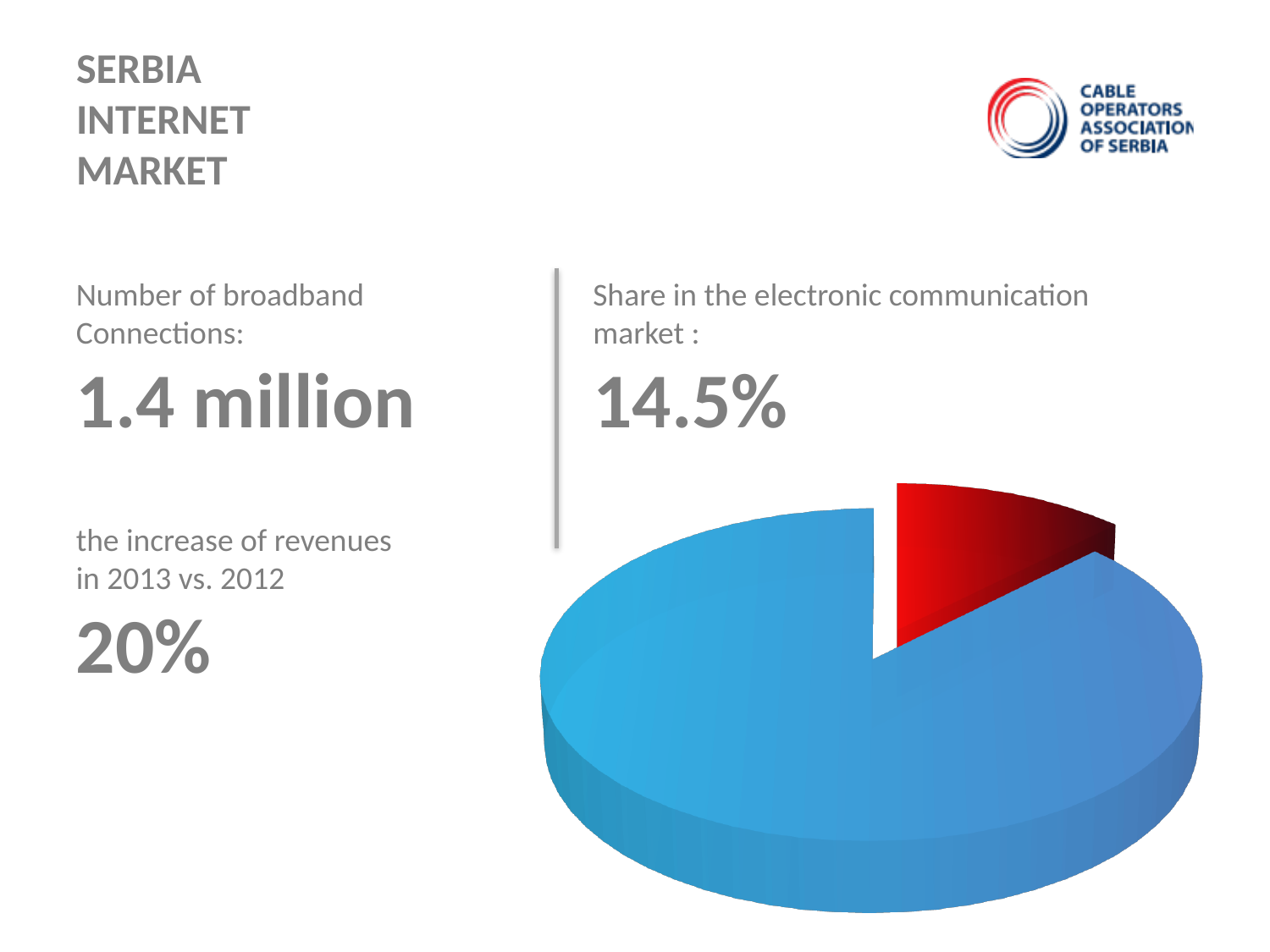
Which slice of the pie chart is the largest? the blue slice Which slice of the pie chart is the smallest? the red slice Is the share represented by the blue slice of the pie chart greater or less than 50%? greater What kind of chart is shown on the slide? pie chart What colour is the larger slice of the pie chart? blue Which slice of the pie chart is larger, the blue one or the red one? the blue one How many slices does the pie chart have? 2 What share of the electronic communication market does the red slice of the pie chart represent? 14.5% Is the share represented by the red slice of the pie chart greater or less than 50%? less What colour is the smaller slice of the pie chart? red